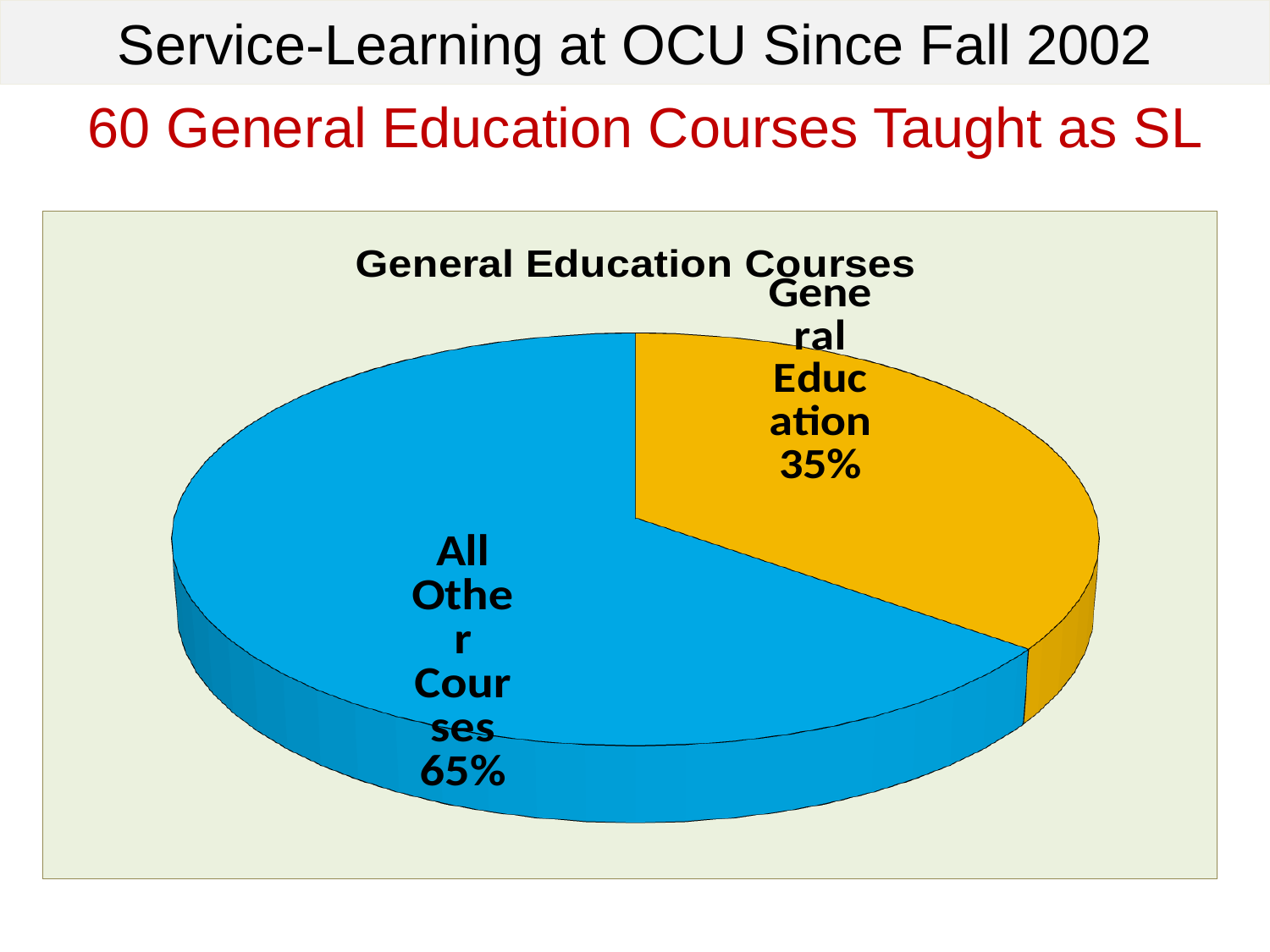
What is the difference in percentage points between All Other Courses and General Education? 30 What share of the pie is General Education? 35% Which slice is the smallest? General Education What type of chart is shown on the slide? pie chart Which is larger, the General Education slice or the All Other Courses slice? All Other Courses What colour is the General Education slice? yellow Is the share for General Education greater or less than 50%? less Which slice is the largest? All Other Courses What is the title of the chart? General Education Courses How many slices does the pie chart have? 2 What share of the pie is All Other Courses? 65%